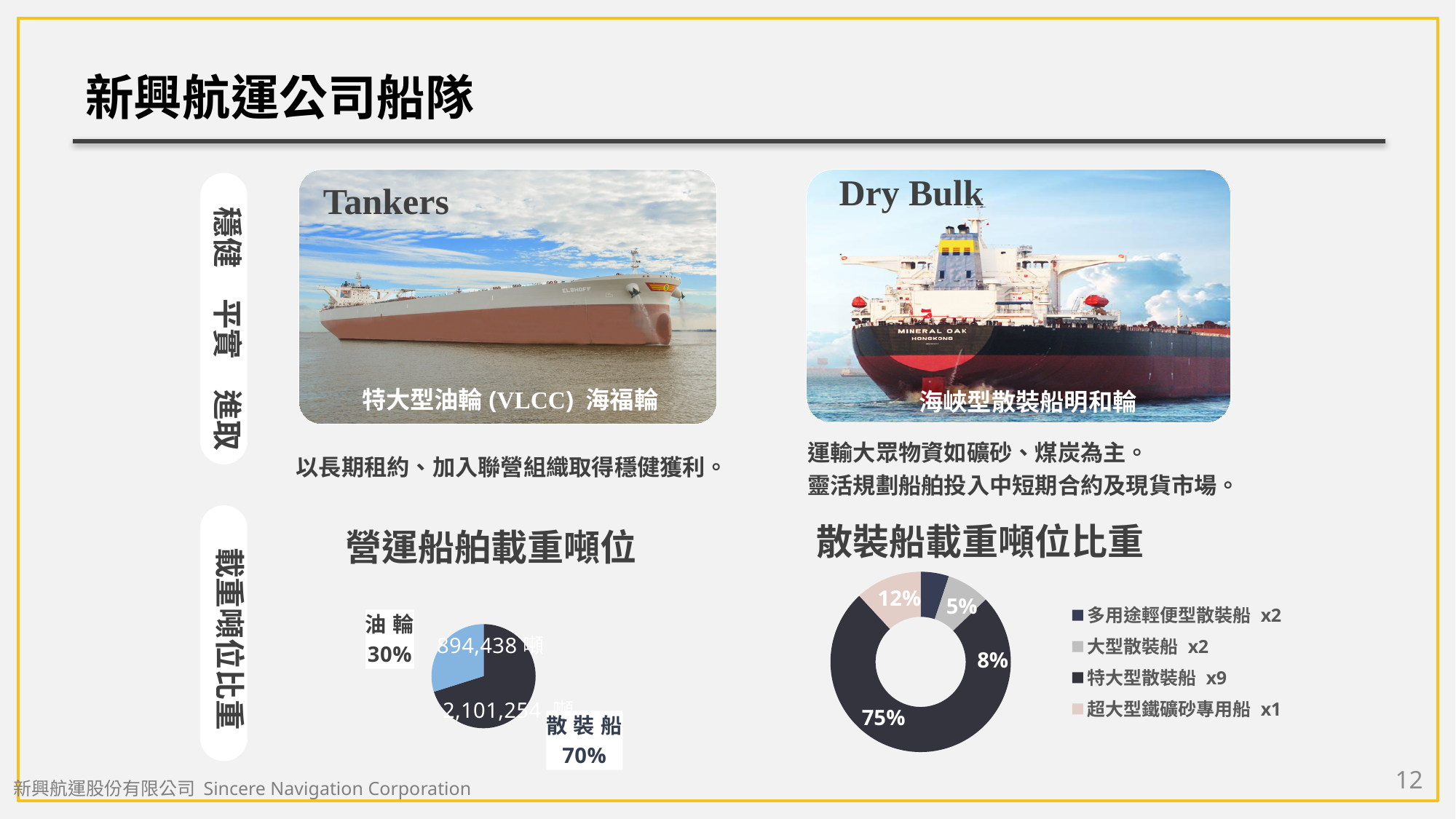
In the 營運船舶載重噸位 pie chart, what is the tonnage shown for 油輪? 894,438 噸 What kind of chart is the 營運船舶載重噸位 chart? Pie chart How many entries does the legend of the 散裝船載重噸位比重 chart list? 4 In the 營運船舶載重噸位 pie chart, what share does 散裝船 have? 70% In the 散裝船載重噸位比重 chart, what share does 超大型鐵礦砂專用船 have? 12% In the 營運船舶載重噸位 pie chart, what share does 油輪 have? 30% In the 營運船舶載重噸位 pie chart, which category has the larger tonnage, 油輪 or 散裝船? 散裝船 In the 散裝船載重噸位比重 chart, which category has the largest share? 特大型散裝船 In the 營運船舶載重噸位 pie chart, what is the difference in tonnage between 散裝船 and 油輪? 1,206,816 噸 How many categories does the 營運船舶載重噸位 pie chart show? 2 In the 營運船舶載重噸位 pie chart, what is the tonnage shown for 散裝船? 2,101,254 噸